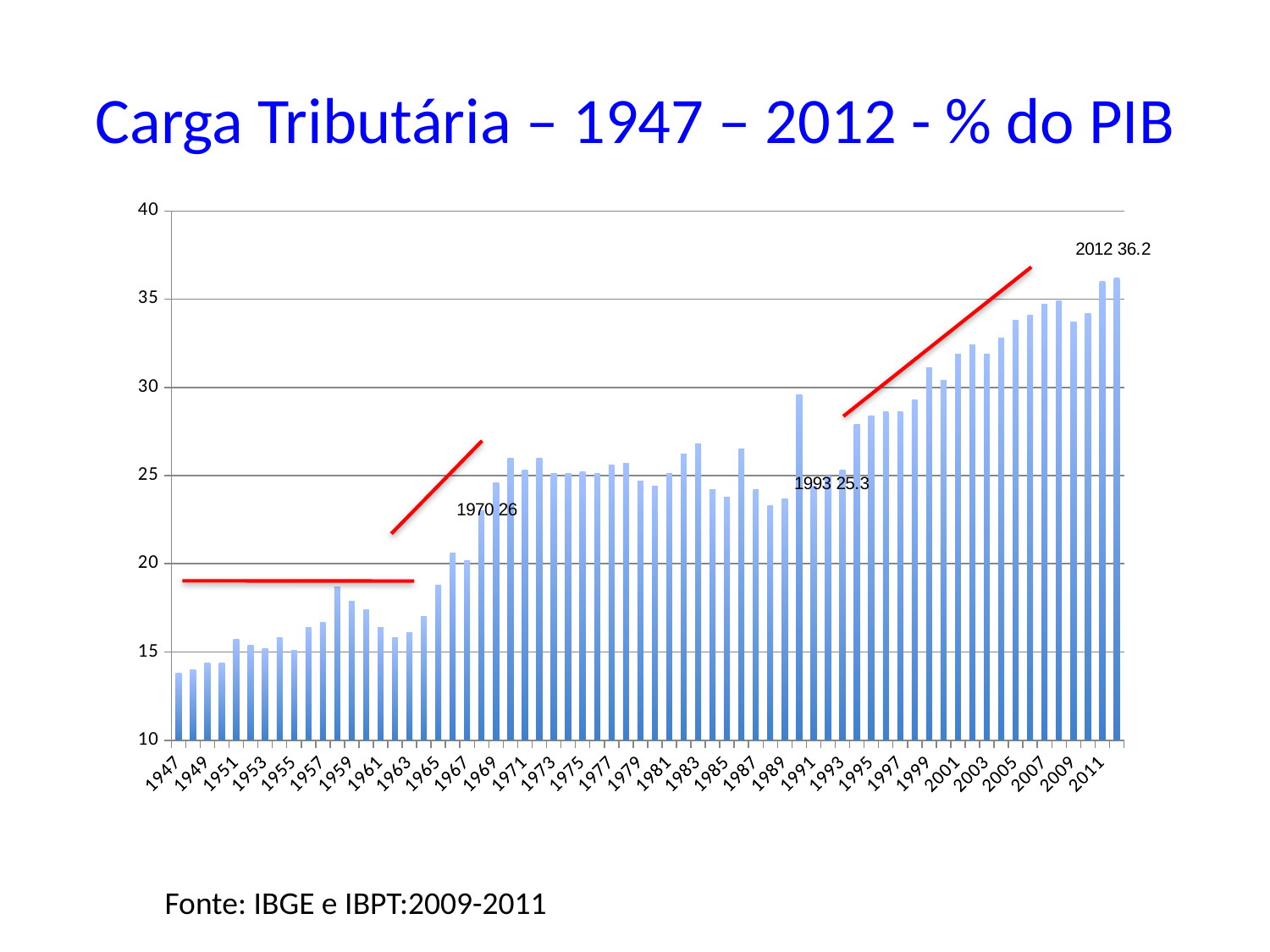
What is the difference between the values for 2012 and 1970? 10.2 What is the value for 1970? 26 Is the value for 1947 greater or less than 15? less Do the values generally rise or fall from 1947 to 2012? rise Is the value for 1990 greater or less than 25? greater What is the value for 2012? 36.2 What is the value for 1993? 25.3 Which is larger, the value for 1970 or the value for 1993? 1970 What is the title of the chart? Carga Tributária – 1947 – 2012 - % do PIB What is the difference between the values for 2012 and 1993? 10.9 What kind of chart is shown on the slide? bar chart Is the value for 2005 greater or less than 30? greater